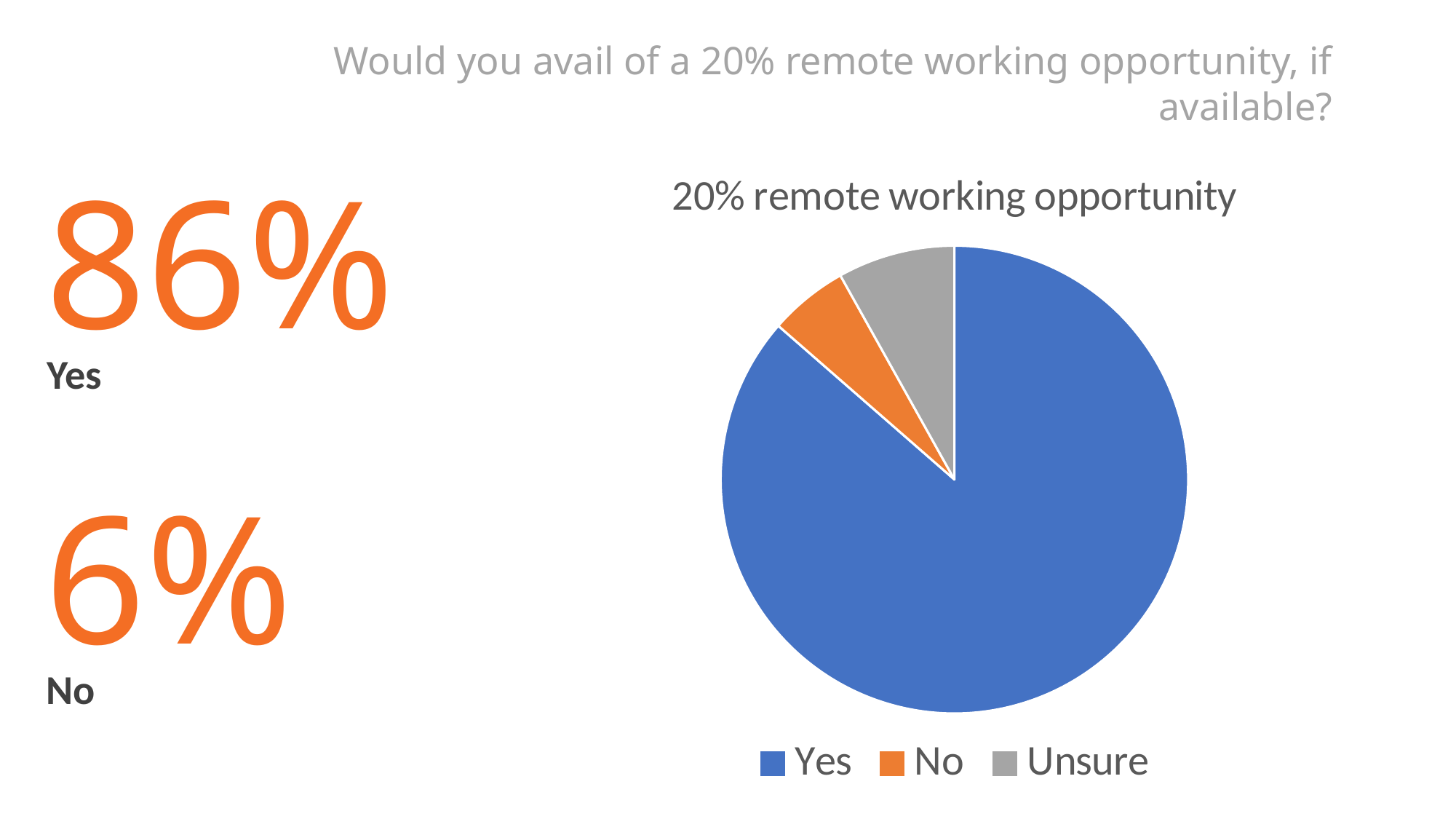
Which category has the largest slice of the pie chart? Yes What kind of chart is shown on the slide? pie chart What percentage of respondents answered No? 6% Which category has the smallest slice of the pie chart? No What is the title of the pie chart? 20% remote working opportunity How many categories does the pie chart legend list? 3 What colour is the Yes slice in the pie chart? blue What is the difference in percentage points between the Yes and No responses? 80 Which slice is larger, No or Unsure? Unsure Which slice is larger, Yes or Unsure? Yes What percentage of respondents answered Yes? 86% How many slices does the pie chart have? 3